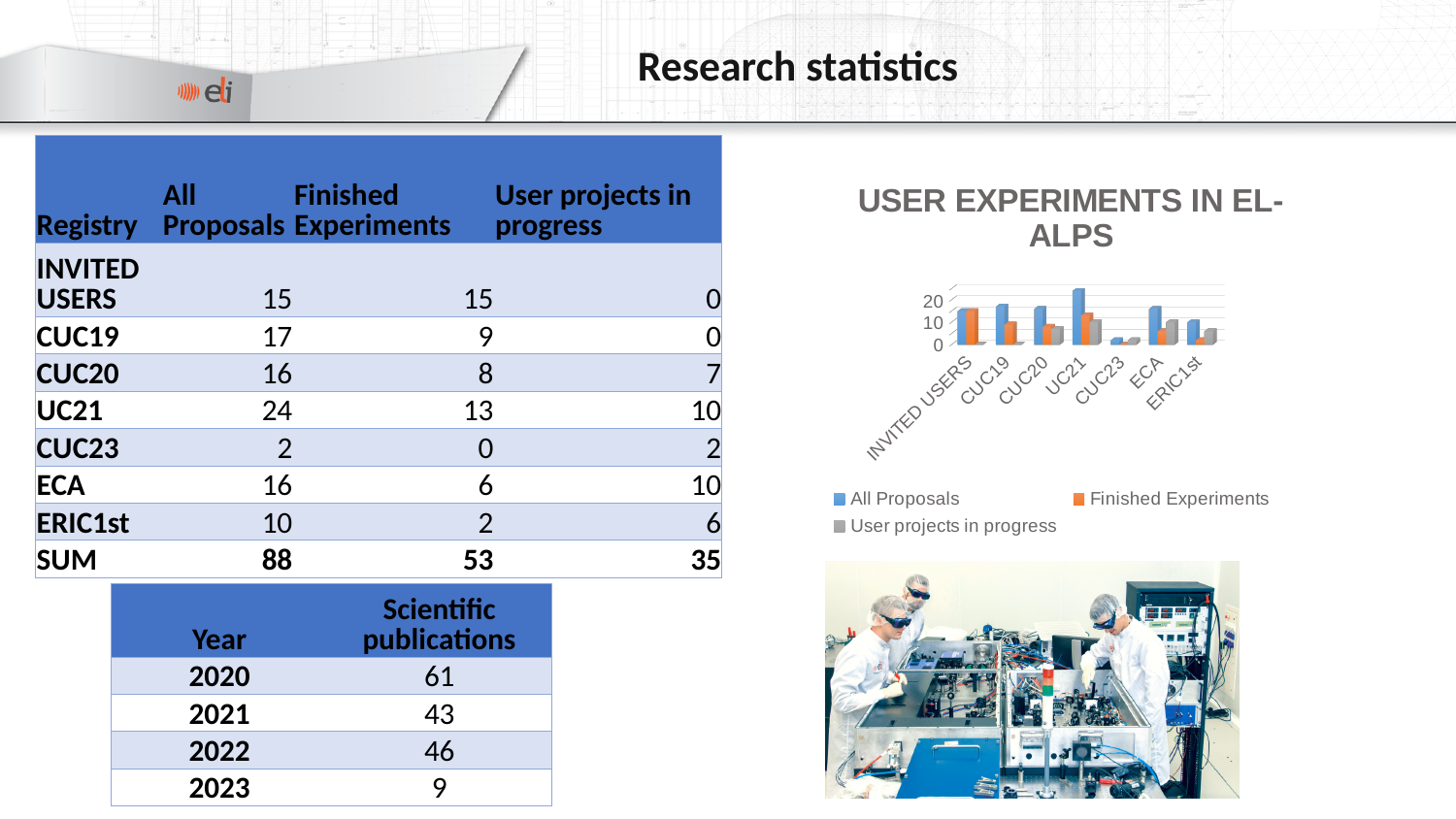
In the 'USER EXPERIMENTS IN EL-ALPS' chart, which is larger: the All Proposals value for ECA or for ERIC1st? ECA What kind of chart is shown under the title 'USER EXPERIMENTS IN EL-ALPS'? bar chart What is the title of the chart on the right side of the slide? USER EXPERIMENTS IN EL-ALPS In the 'USER EXPERIMENTS IN EL-ALPS' chart, which category has the highest All Proposals value? UC21 In the 'USER EXPERIMENTS IN EL-ALPS' chart, is the All Proposals value for CUC23 greater or less than 10? less In the 'USER EXPERIMENTS IN EL-ALPS' chart, which category has the lowest All Proposals value? CUC23 What is the All Proposals value for UC21 in the 'USER EXPERIMENTS IN EL-ALPS' chart? 24 What is the Finished Experiments value for INVITED USERS in the 'USER EXPERIMENTS IN EL-ALPS' chart? 15 How many series does the legend of the 'USER EXPERIMENTS IN EL-ALPS' chart list? 3 In the 'USER EXPERIMENTS IN EL-ALPS' chart, what is the difference between the All Proposals and Finished Experiments values for UC21? 11 In the 'USER EXPERIMENTS IN EL-ALPS' chart, is the All Proposals value for UC21 greater or less than 20? greater How many categories are shown on the x axis of the 'USER EXPERIMENTS IN EL-ALPS' chart? 7